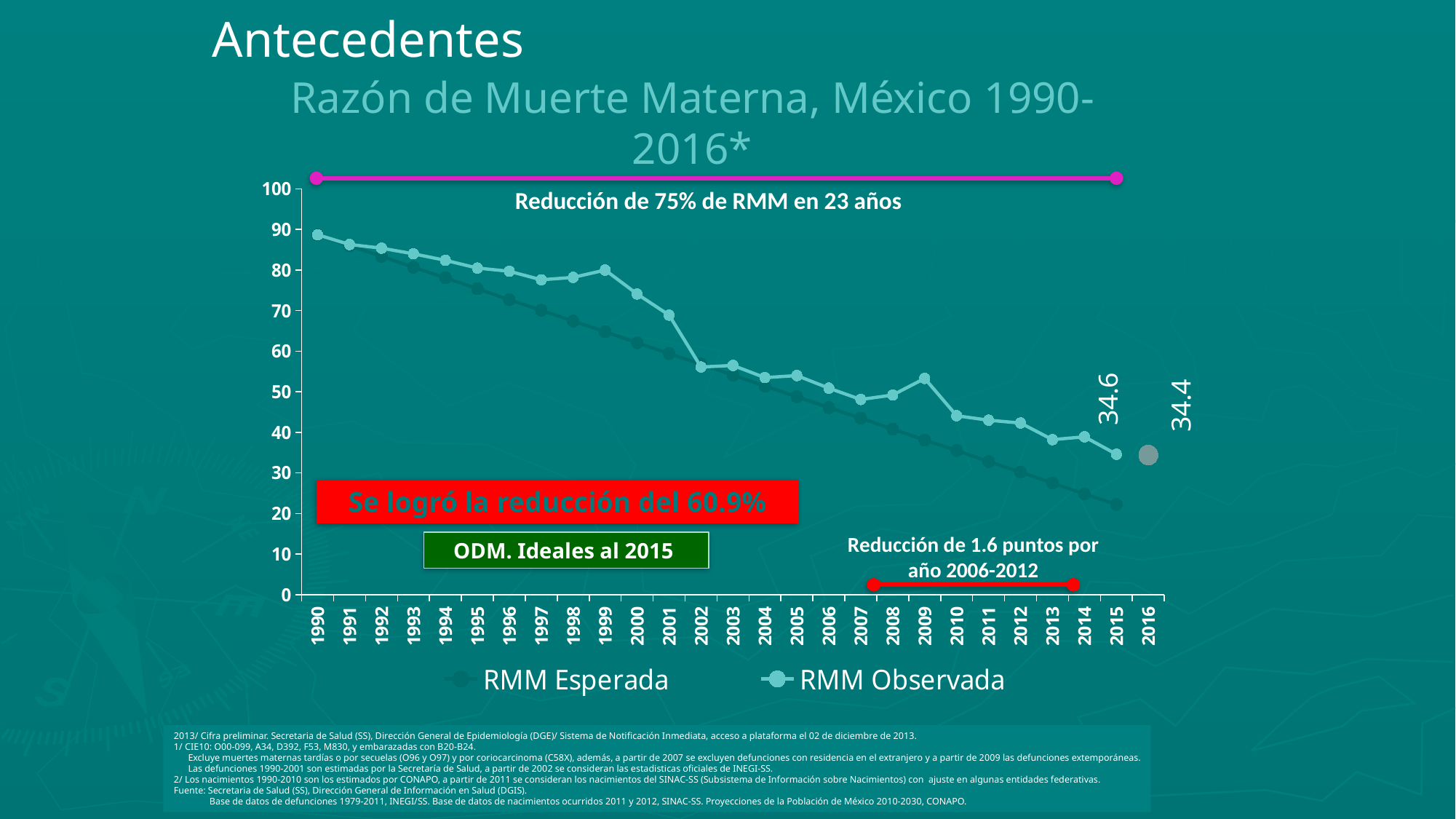
What is the title of the chart? Razón de Muerte Materna, México 1990-2016* How many series does the legend list? 2 What are the two series named in the legend? RMM Esperada and RMM Observada What is the labelled value of RMM Observada for 2015? 34.6 Do the RMM Observada values generally rise or fall from 1990 to 2015? fall Is the value of RMM Observada for 1990 greater or less than 80? greater What is the labelled value shown for 2016? 34.4 Is the value of RMM Observada for 2010 greater or less than 50? less What kind of chart is shown on the slide? line chart How many years are shown on the x axis? 27 Is the value of RMM Esperada for 2015 greater or less than 30? less Which year has the highest RMM Observada value? 1990